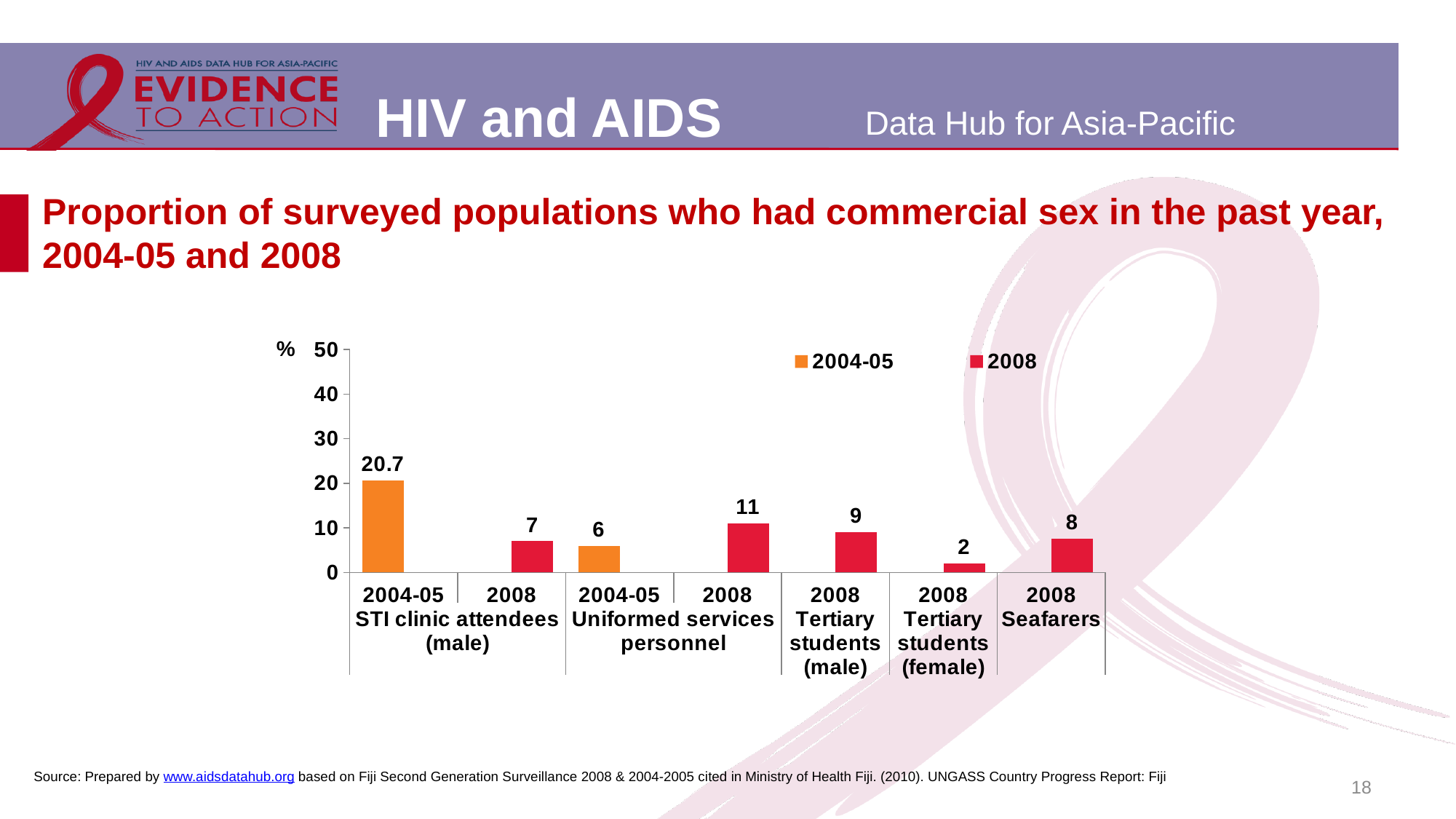
Which bar has the lowest value? Tertiary students (female), 2008 What is the value for Tertiary students (female) in 2008? 2 What kind of chart is shown? Bar chart Which bar has the highest value? STI clinic attendees (male), 2004-05 Which is larger: the 2008 value for Tertiary students (male) or the 2008 value for Seafarers? Tertiary students (male) What is the value for STI clinic attendees (male) in 2004-05? 20.7 What is the value for STI clinic attendees (male) in 2008? 7 What is the difference between the 2004-05 and 2008 values for STI clinic attendees (male)? 13.7 What is the value for Uniformed services personnel in 2008? 11 How many series does the legend list? 2 What is the value for Seafarers in 2008? 8 How many bars are plotted on the chart? 7